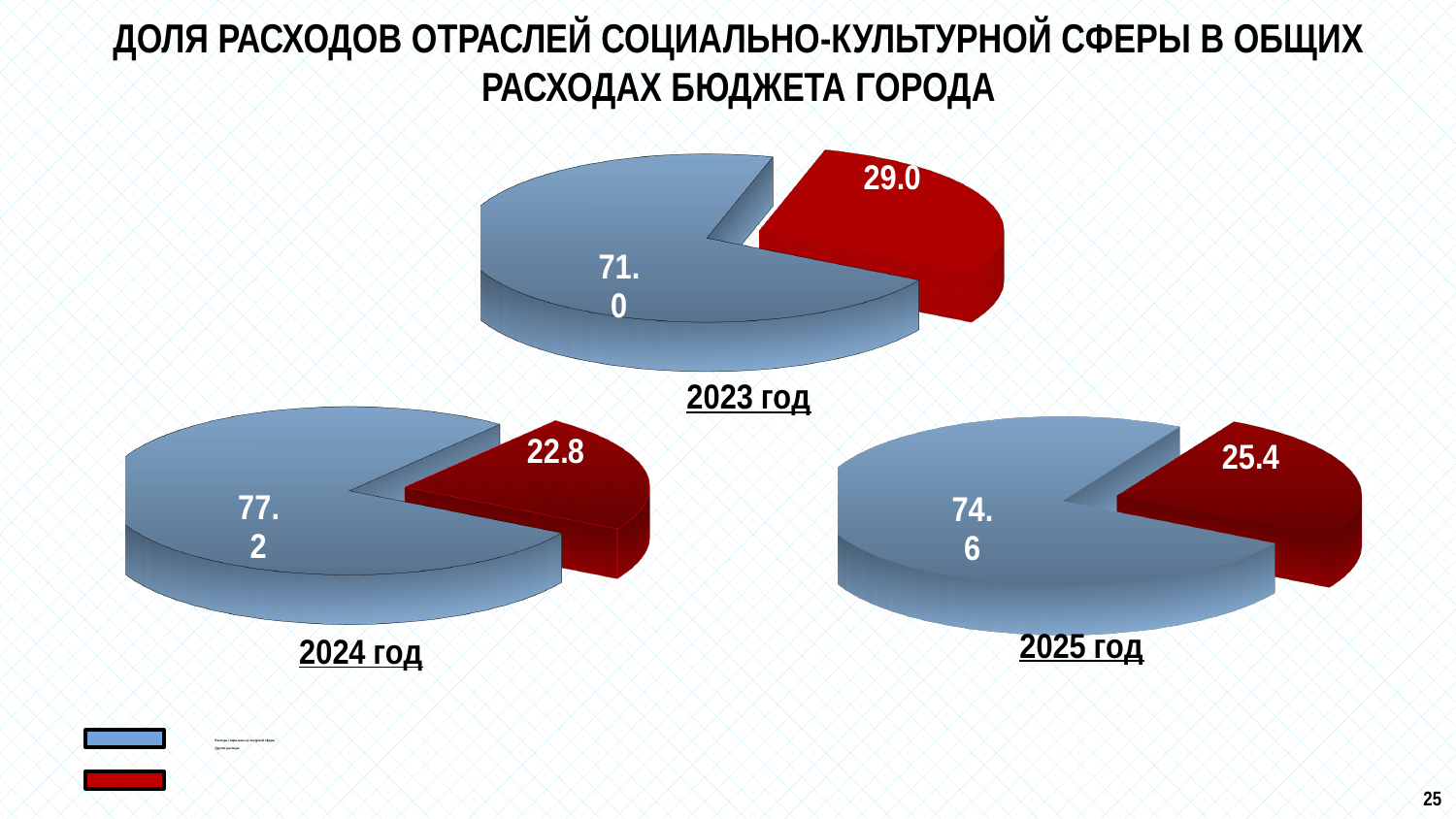
How many pie charts are shown on the slide? 3 In the 2024 год pie chart, what value is shown on the blue slice? 77.2 In the 2023 год pie chart, what value is shown on the blue slice? 71.0 In the 2024 год pie chart, what value is shown on the red slice? 22.8 In the 2023 год pie chart, what is the difference between the blue slice value and the red slice value? 42.0 In the 2025 год pie chart, what value is shown on the blue slice? 74.6 In the 2025 год pie chart, what value is shown on the red slice? 25.4 Across the three pie charts, which year has the largest blue slice? 2024 год Across the three pie charts, which year has the smallest red slice? 2024 год In the 2025 год pie chart, which slice is larger, the blue one or the red one? blue In the 2023 год pie chart, what value is shown on the red slice? 29.0 What type of chart is used for each year on this slide? pie chart